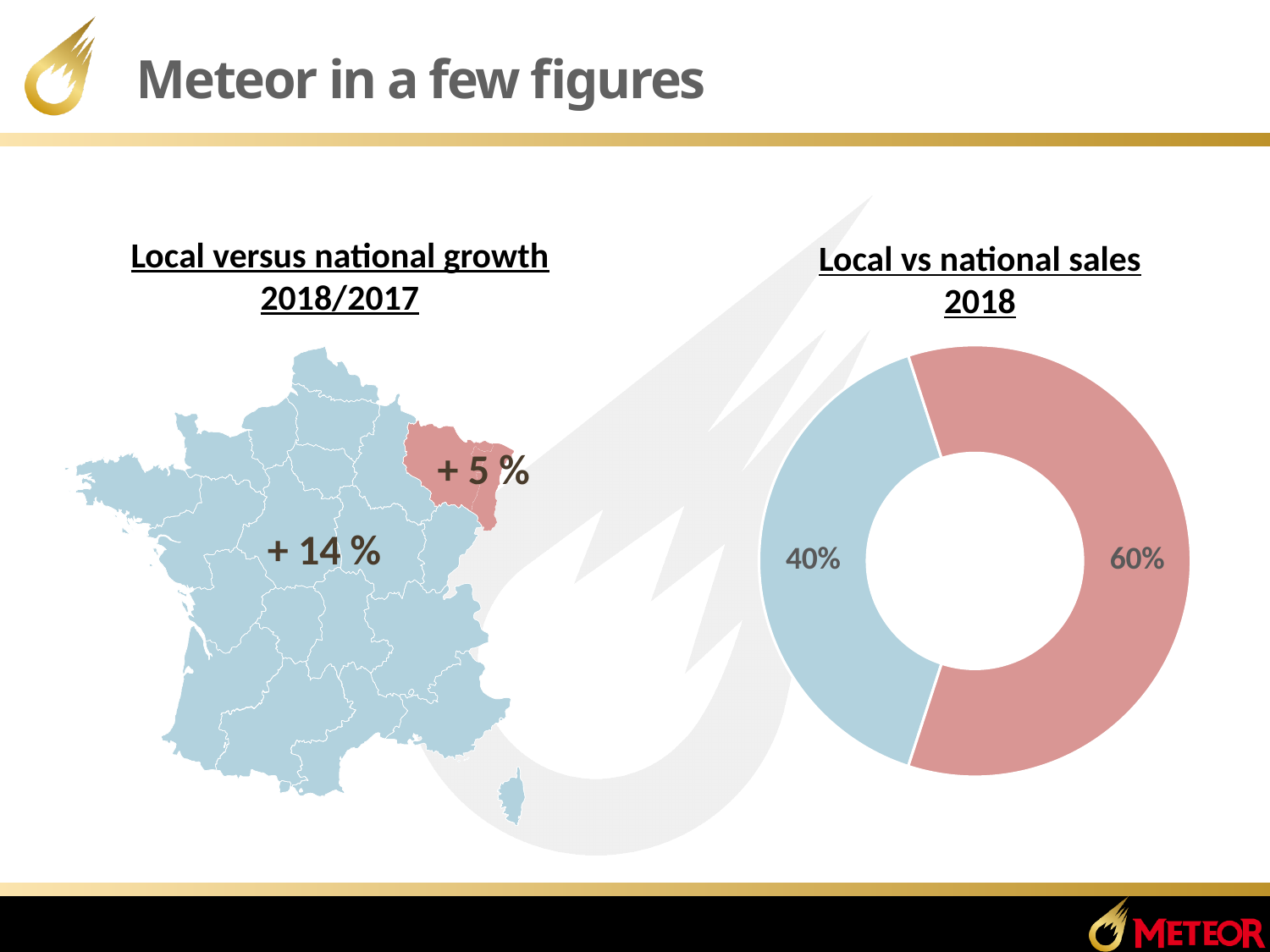
In the "Local vs national sales 2018" chart, what percentage is shown on the blue slice? 40% On the "Local versus national growth 2018/2017" map, which growth figure is larger, the one on the red region or the one on the blue area? the blue area (+ 14 %) Does the "Local vs national sales 2018" doughnut chart display a legend? No In the "Local vs national sales 2018" chart, what is the difference between the two slices? 20% On the "Local versus national growth 2018/2017" map, what growth figure is printed on the blue part of France? + 14 % How many slices does the "Local vs national sales 2018" doughnut chart have? 2 In the "Local vs national sales 2018" chart, is the blue slice larger or smaller than the red slice? smaller In the "Local vs national sales 2018" chart, which slice is the smallest? the blue slice (40%) On the "Local versus national growth 2018/2017" map, what growth figure is printed on the red highlighted region? + 5 % What kind of chart is shown under the title "Local vs national sales 2018"? doughnut chart In the "Local vs national sales 2018" chart, what percentage is shown on the red slice? 60% In the "Local vs national sales 2018" chart, which slice is the largest? the red slice (60%)